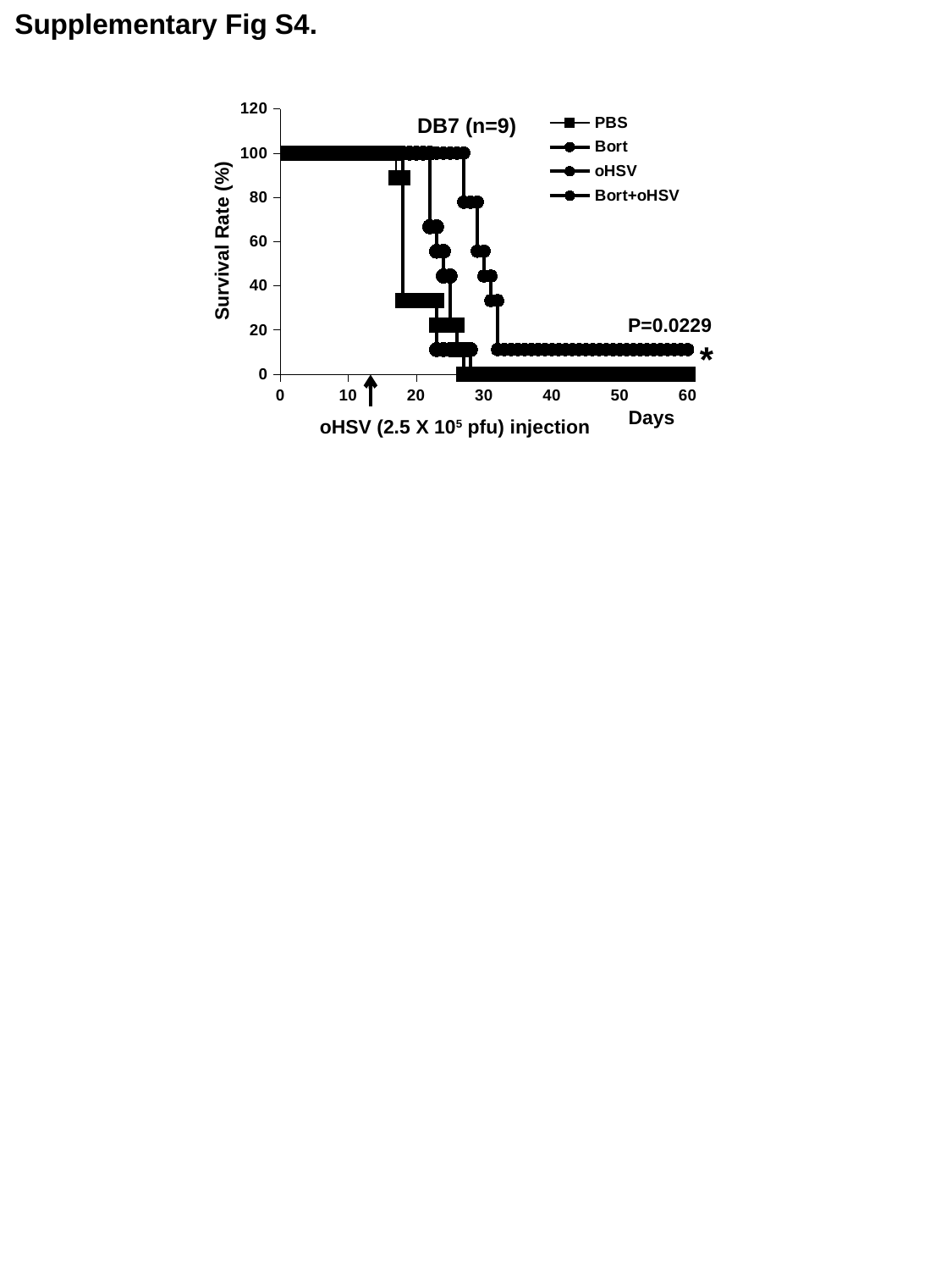
At day 40, is the survival rate of the PBS group greater or less than 20? less At day 10, is the survival rate of every group greater or less than 80? greater What kind of chart is shown on the slide? line chart What P value is annotated on the chart? P=0.0229 How many series does the legend list? 4 At day 60, is the survival rate of the longest-surviving group greater or less than 20? less Do the survival rates rise or fall as the days increase? fall What is the survival rate of all groups at day 0? 100 What is the title of the chart? DB7 (n=9)